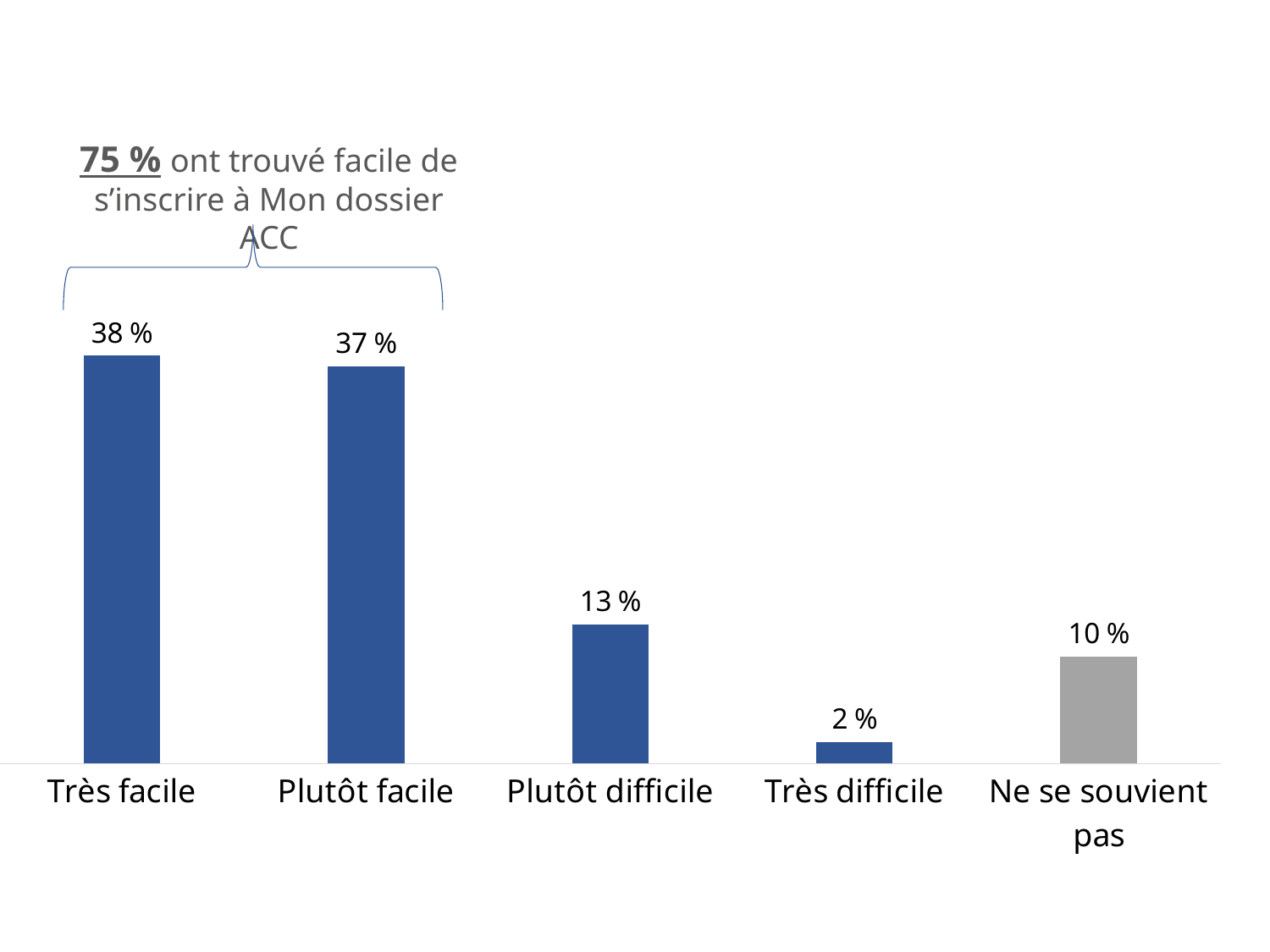
What is the value for Très facile? 38 % What is the difference between the values for Très facile and Plutôt difficile? 25 % Which is larger, the value for Plutôt difficile or the value for Ne se souvient pas? Plutôt difficile Which bar is coloured grey rather than blue? Ne se souvient pas What is the value for Plutôt difficile? 13 % What is the value for Très difficile? 2 % What kind of chart is this? Bar chart What is the value for Plutôt facile? 37 % Which category has the highest value? Très facile Which category has the lowest value? Très difficile How many categories are shown on the chart? 5 What is the value for Ne se souvient pas? 10 %